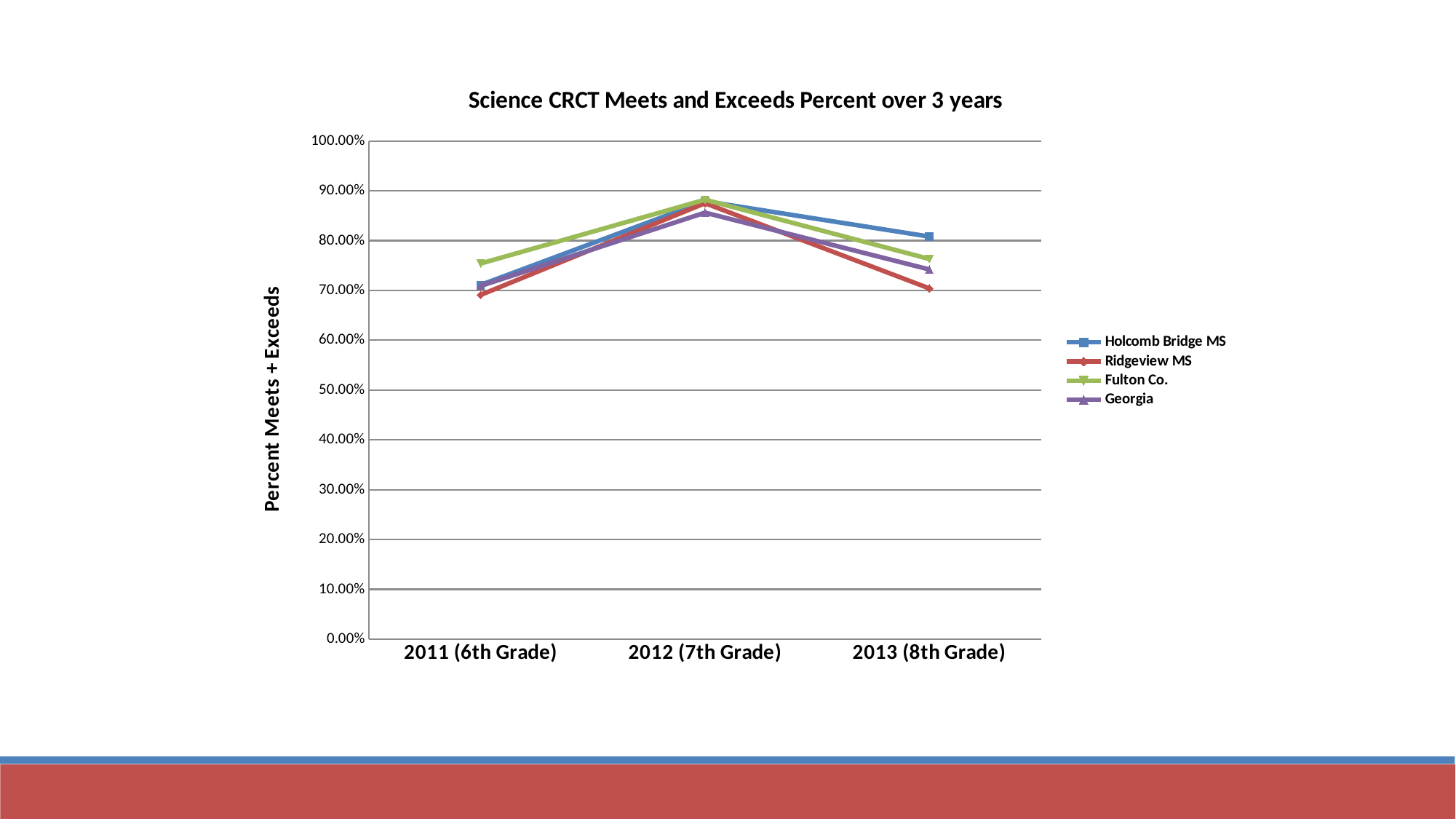
Is the value for Georgia in 2012 (7th Grade) greater or less than 80.00%? greater Is the value for Holcomb Bridge MS in 2013 (8th Grade) greater or less than 80.00%? greater In 2013 (8th Grade), which is larger: Holcomb Bridge MS or Ridgeview MS? Holcomb Bridge MS Does the Holcomb Bridge MS line rise or fall from 2012 (7th Grade) to 2013 (8th Grade)? fall How many categories are shown on the x axis? 3 Which series has the lowest value in 2013 (8th Grade)? Ridgeview MS How many series does the legend list? 4 Which series has the highest value in 2013 (8th Grade)? Holcomb Bridge MS Which series has the highest value in 2011 (6th Grade)? Fulton Co. Is the value for Ridgeview MS in 2013 (8th Grade) greater or less than 80.00%? less What kind of chart is shown on the slide? line chart